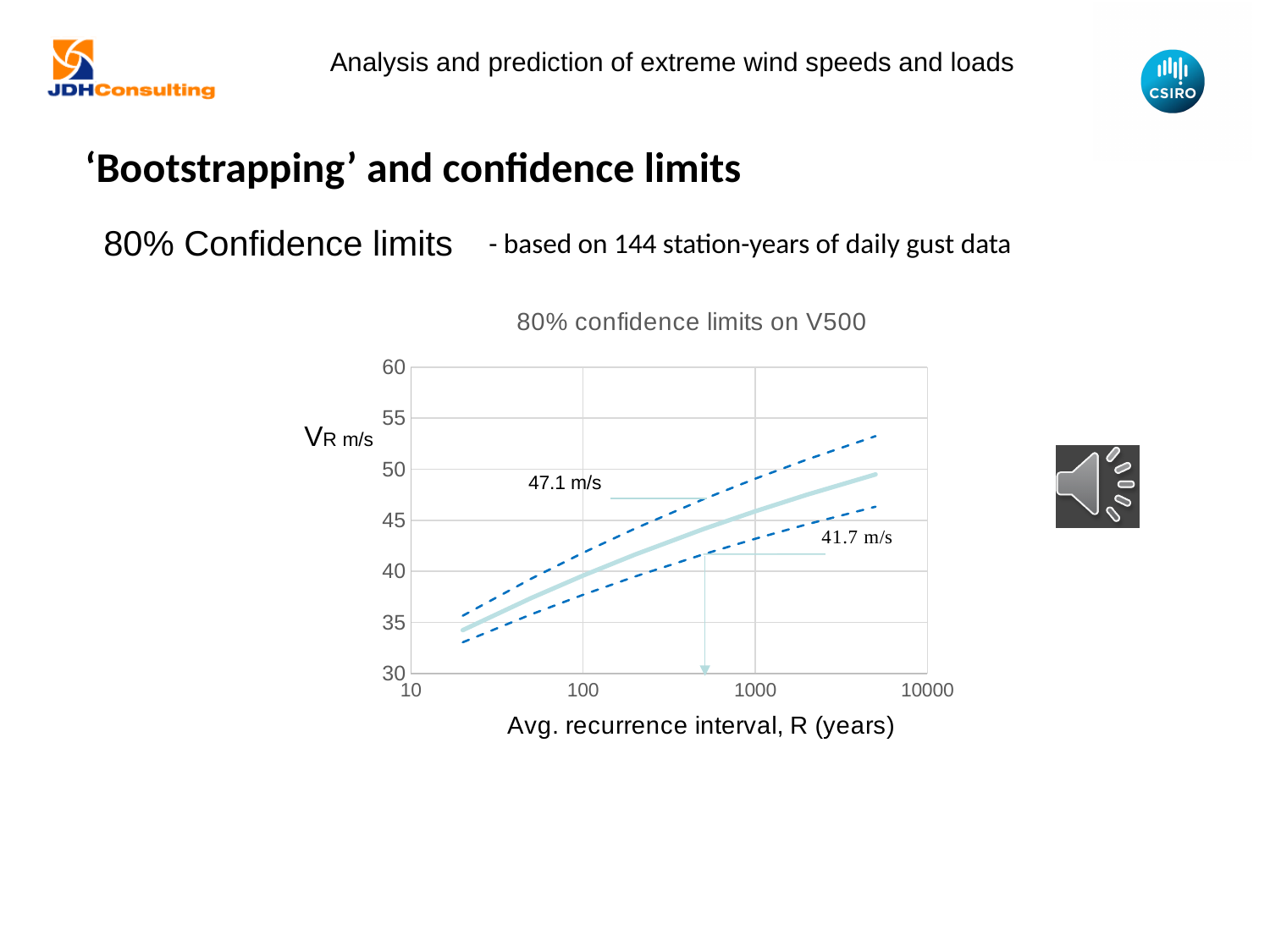
What kind of chart is shown on the slide? line chart Which labelled value is larger, the upper confidence limit (47.1 m/s) or the lower confidence limit (41.7 m/s)? 47.1 m/s What value is labelled on the upper confidence limit at R = 500 years? 47.1 m/s What is the difference between the labelled upper and lower confidence limits at R = 500 years? 5.4 m/s How many lines are plotted on the chart? 3 Is the value of the solid central line at R = 100 years greater or less than 45? less Is the value of the lower dashed confidence limit at R = 100 years greater or less than 40? less What is the title of the chart? 80% confidence limits on V500 Is the value of the upper dashed confidence limit at R = 1000 years greater or less than 45? greater What is the label of the x axis of the chart? Avg. recurrence interval, R (years) Do the plotted lines rise or fall as the average recurrence interval increases? rise What value is labelled on the lower confidence limit at R = 500 years? 41.7 m/s